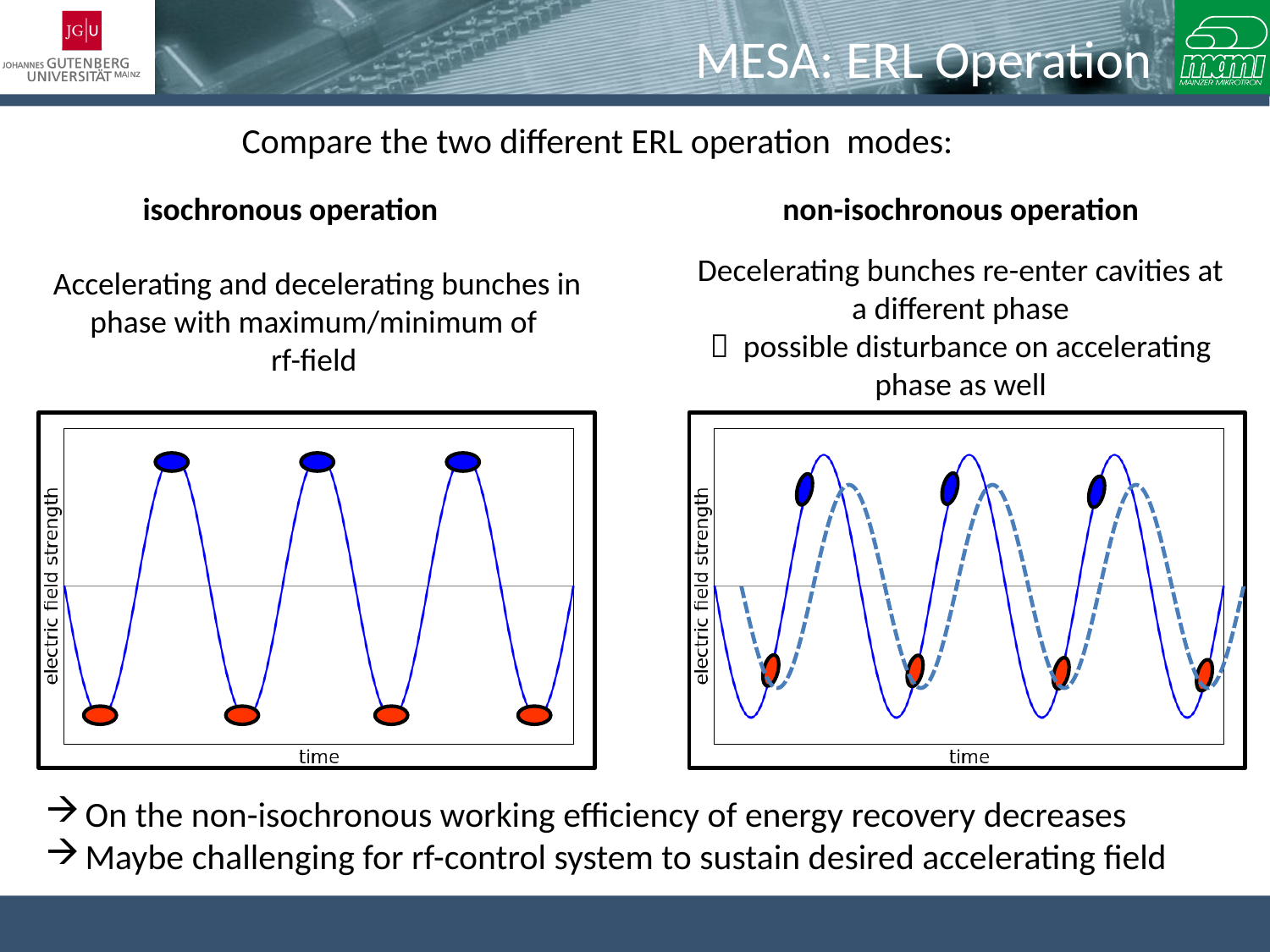
In the left chart (isochronous operation), how many blue ellipses are placed on the curve? 3 In the left chart (isochronous operation), are the blue ellipses located at the maxima or the minima of the curve? maxima In the right chart (non-isochronous operation), how many blue ellipses are placed on the curve? 3 In the left chart (isochronous operation), how many red ellipses are placed on the curve? 4 In the left chart (isochronous operation), are the red ellipses located at the maxima or the minima of the curve? minima What is the label on the horizontal axis of the right chart (non-isochronous operation)? time What kind of chart is shown under the isochronous operation heading on the left? line chart Which of the two charts contains a dashed curve in addition to the solid blue curve? the right chart (non-isochronous operation)